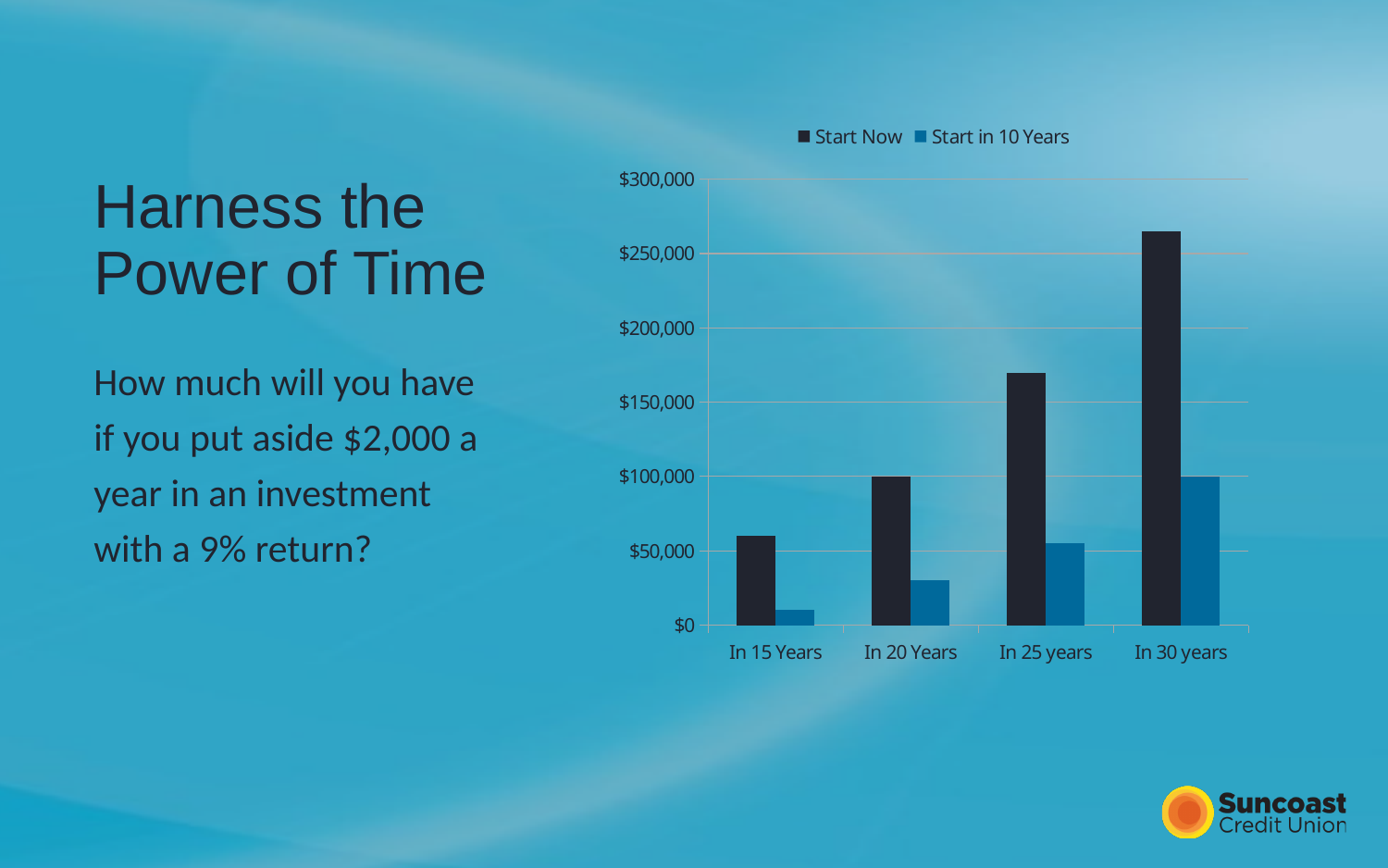
Is the Start Now value for In 30 years greater or less than $250,000? greater What kind of chart is shown on the slide? bar chart Which category has the highest value for the Start Now series? In 30 years Is the Start in 10 Years value for In 20 Years greater or less than $50,000? less Do the Start Now values rise or fall as you move from In 15 Years to In 30 years? rise Is the Start Now value for In 25 years greater or less than $150,000? greater What are the two series named in the chart legend? Start Now and Start in 10 Years Which is larger for In 25 years: the Start Now value or the Start in 10 Years value? Start Now Which category has the lowest value for the Start in 10 Years series? In 15 Years How many series does the chart legend list? 2 How many categories are shown on the x axis of the chart? 4